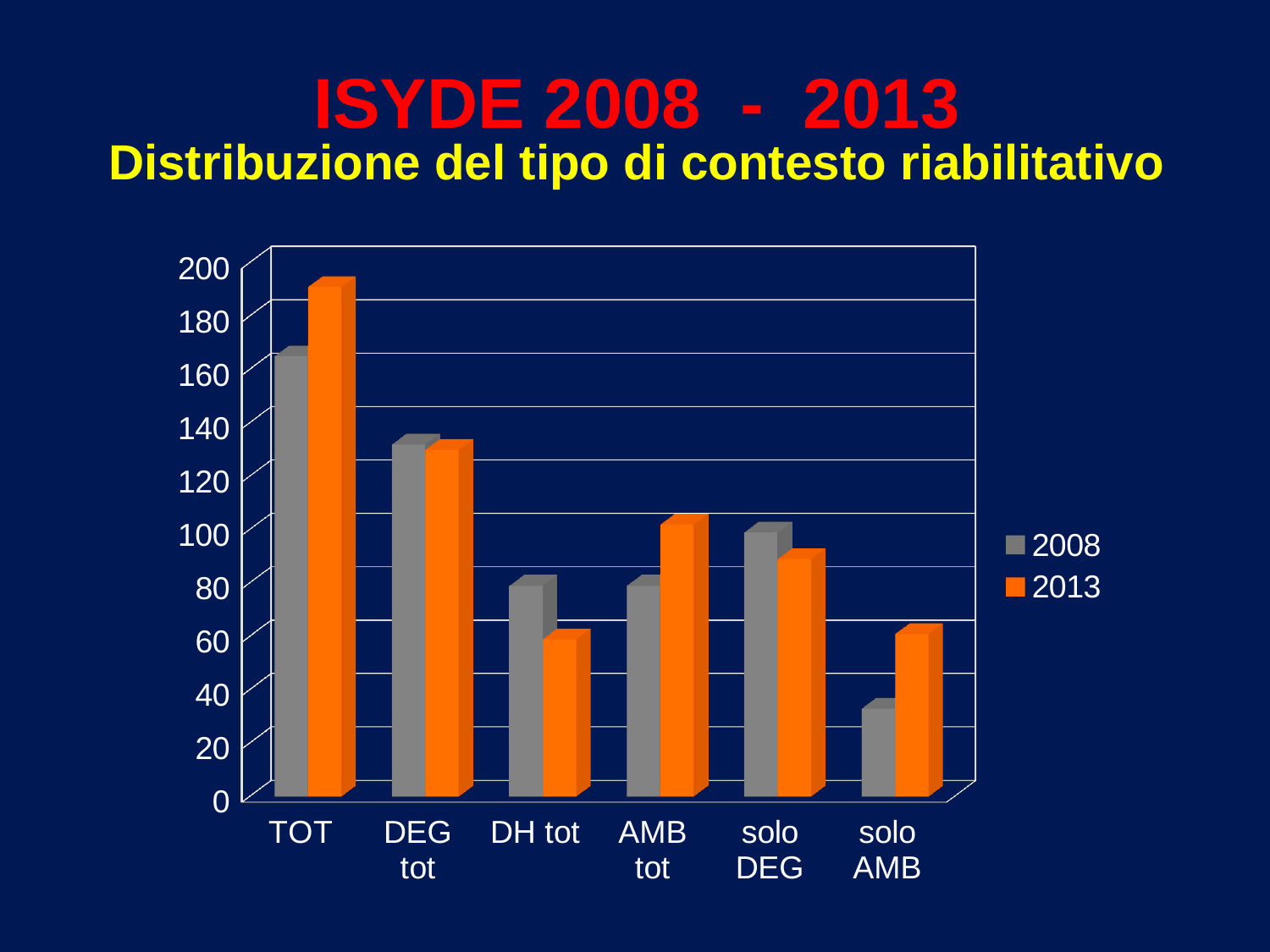
How many series does the legend list? 2 Is the 2013 value for DH tot greater or less than 80? less Which colour represents the 2013 series in the legend? orange Is the 2013 value for AMB tot greater or less than 80? greater For DH tot, which year has the larger value, 2008 or 2013? 2008 What kind of chart is shown on the slide? bar chart Which category has the lowest 2008 value? solo AMB For solo AMB, which year has the larger value, 2008 or 2013? 2013 Is the 2008 value for solo AMB greater or less than 40? less Which category has the highest 2013 value? TOT How many categories are shown on the x axis? 6